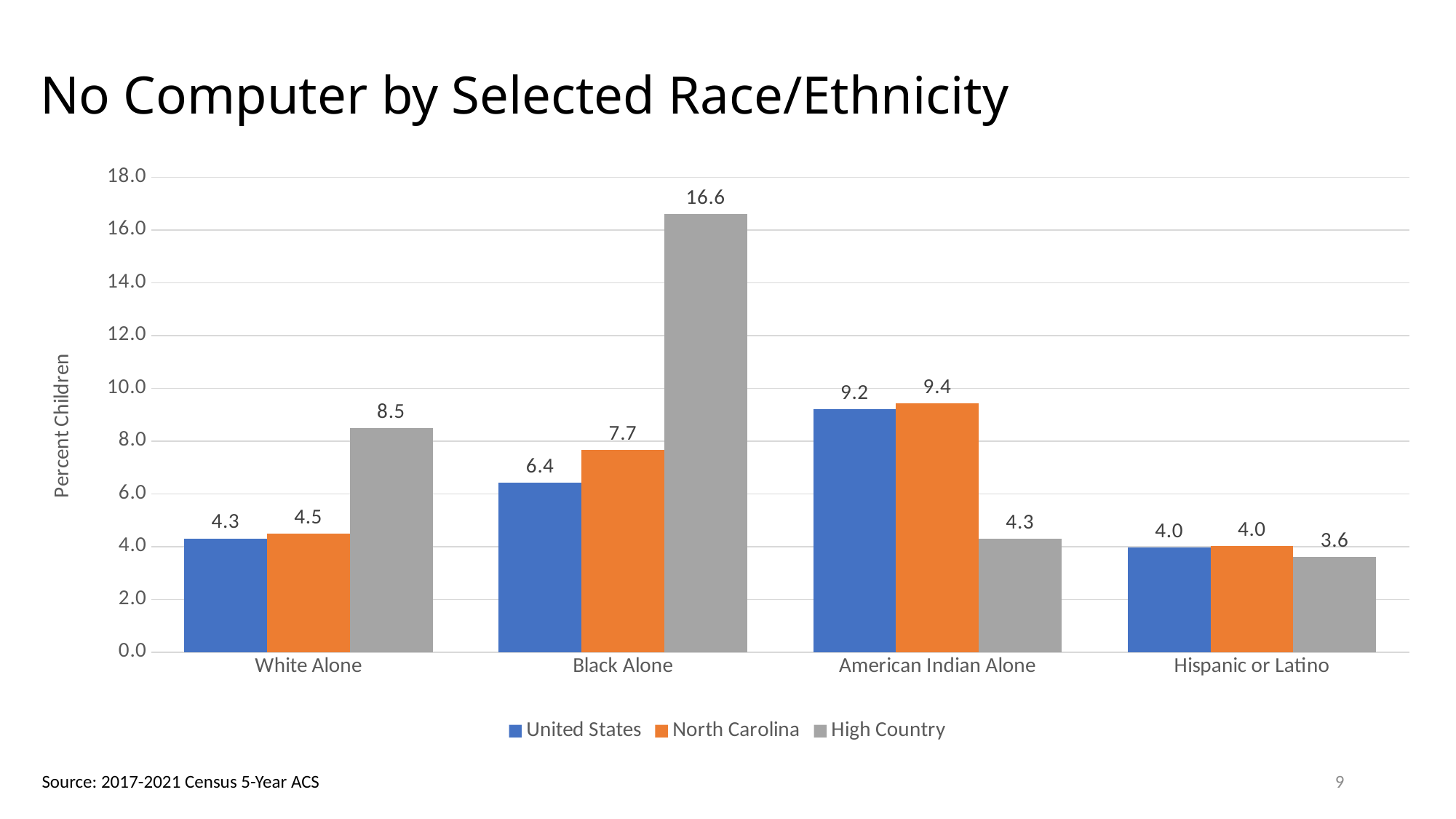
Which is larger for American Indian Alone: the North Carolina value or the High Country value? North Carolina What is the United States value for American Indian Alone? 9.2 How many race/ethnicity categories are shown on the x axis? 4 Which category has the highest High Country value? Black Alone What is the difference between the High Country and North Carolina values for Black Alone? 8.9 Which category has the lowest United States value? Hispanic or Latino What type of chart is shown on the slide? Bar chart What is the High Country value for Black Alone? 16.6 Is the High Country value for White Alone greater or less than 8.0? greater What is the High Country value for Hispanic or Latino? 3.6 What is the North Carolina value for White Alone? 4.5 How many series does the legend list? 3